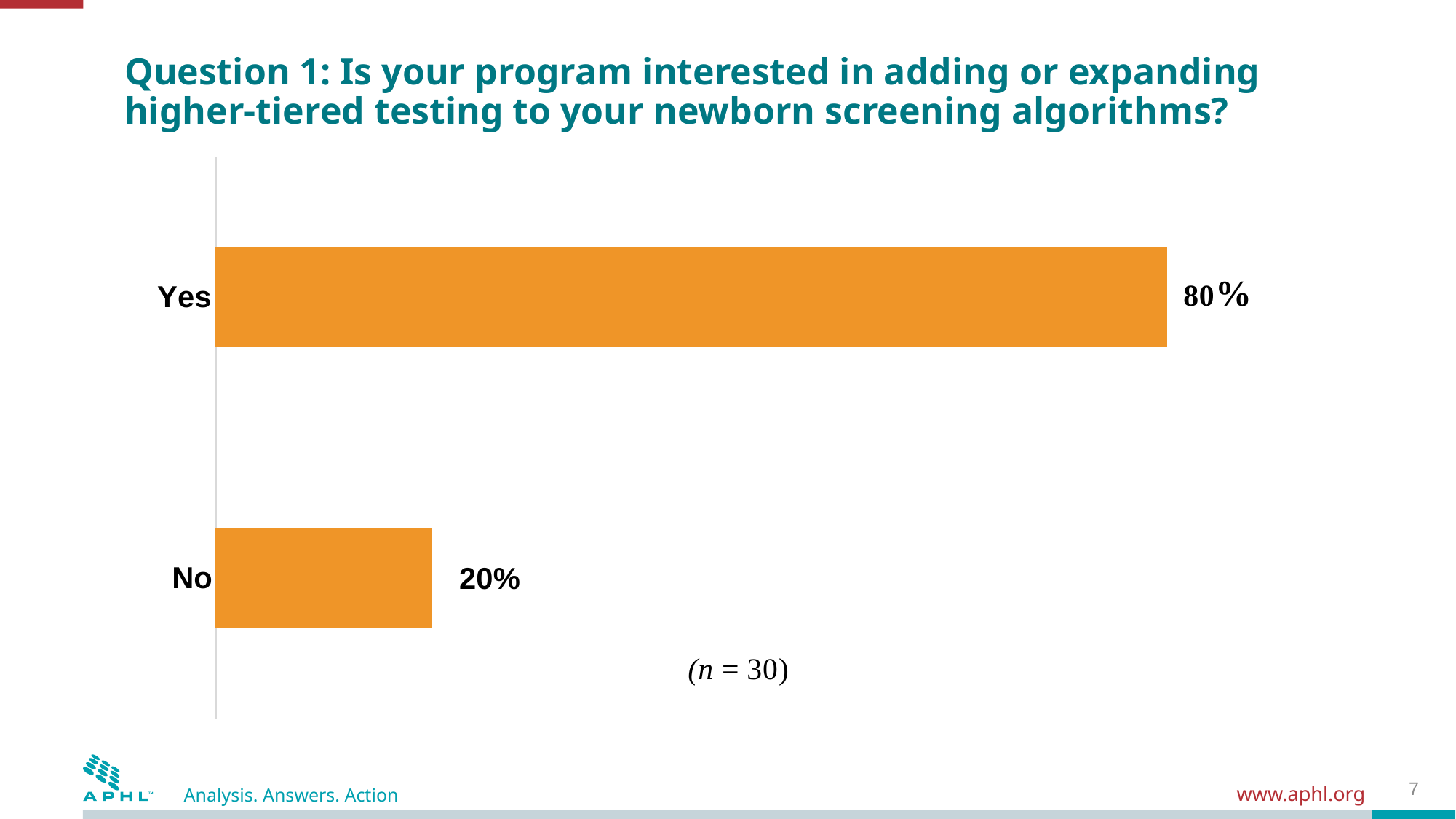
What percentage of programs answered No? 20% What is the difference between the Yes and No percentages? 60% Which response has the highest value? Yes Which response has the lowest value? No What percentage of programs answered Yes? 80% How many response categories are shown in the chart? 2 What kind of chart is shown on the slide? Bar chart What is the total of the Yes and No percentages? 100% What is the sample size (n) noted below the chart? 30 What colour are the bars in the chart? Orange Which is larger, the value for Yes or the value for No? Yes